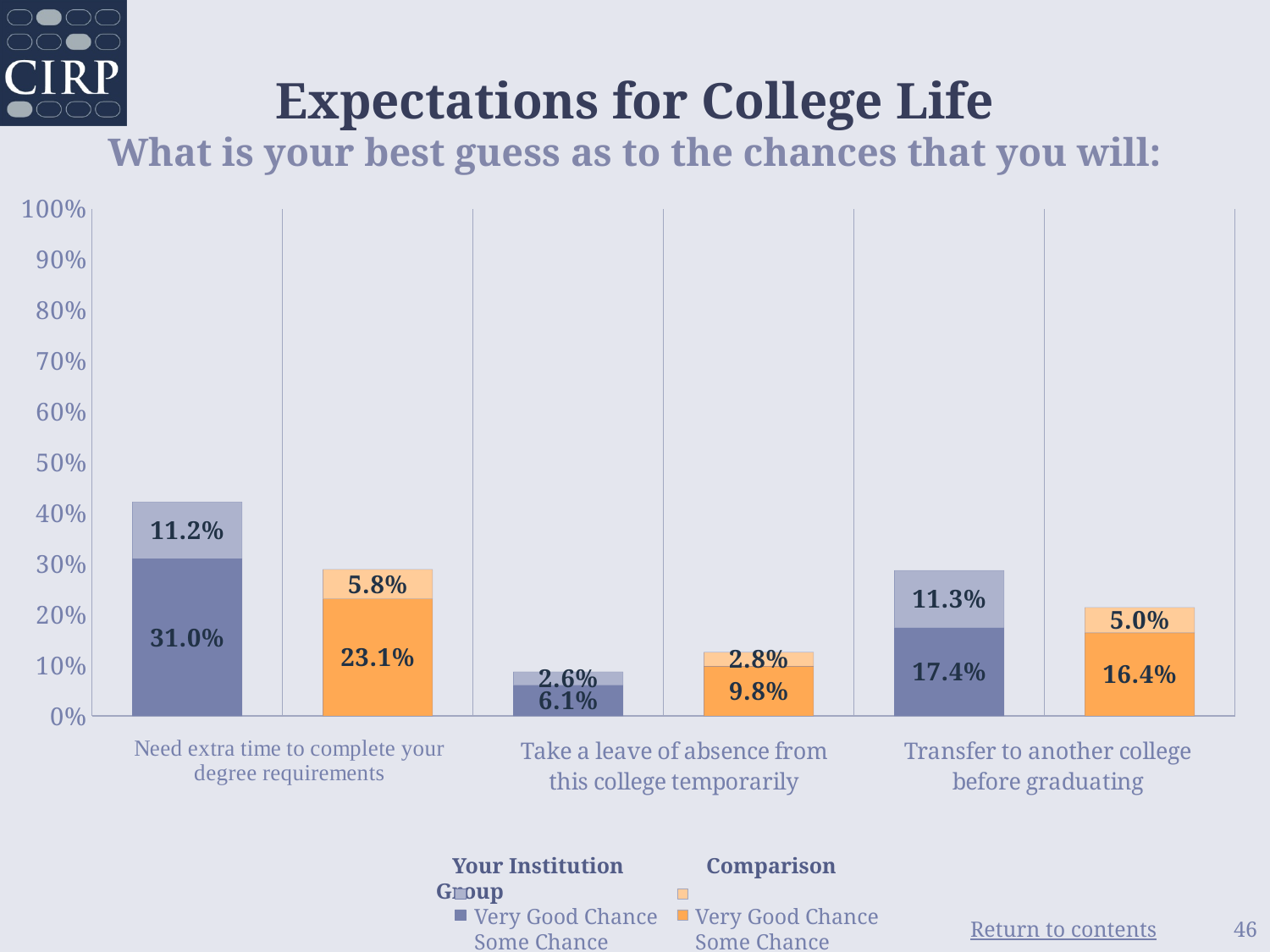
Which is larger for 'Take a leave of absence from this college temporarily': the Your Institution 'Very Good Chance' value or the Comparison Group 'Very Good Chance' value? Comparison Group What is the Your Institution 'Some Chance' value for 'Transfer to another college before graduating'? 17.4% What kind of chart is shown on the slide? Stacked bar chart Which category has the lowest Your Institution 'Very Good Chance' value? Take a leave of absence from this college temporarily What is the Your Institution 'Very Good Chance' value for 'Need extra time to complete your degree requirements'? 11.2% What is the difference between the Your Institution and Comparison Group 'Very Good Chance' values for 'Need extra time to complete your degree requirements'? 5.4% What is the Comparison Group 'Very Good Chance' value for 'Take a leave of absence from this college temporarily'? 2.8% What is the Comparison Group 'Some Chance' value for 'Transfer to another college before graduating'? 16.4% What is the total height of the Your Institution stacked bar for 'Need extra time to complete your degree requirements'? 42.2% What is the total height of the Comparison Group stacked bar for 'Transfer to another college before graduating'? 21.4% How many series does the legend list? 4 How many categories are shown on the x axis? 3